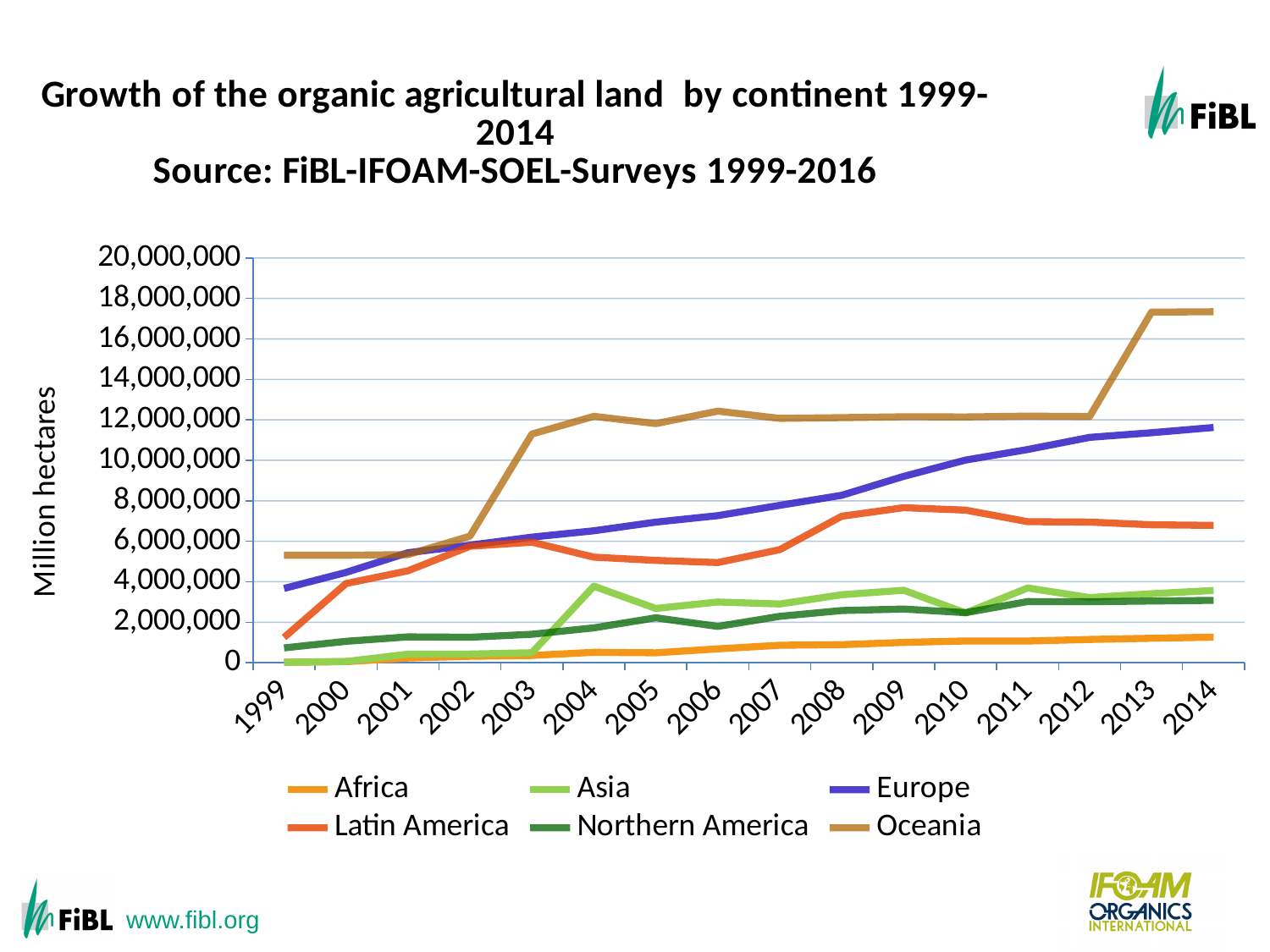
How many series does the legend list? 6 Which continent has the highest organic agricultural land in 1999? Oceania Is the value for Oceania in 2014 greater or less than 16,000,000? greater What kind of chart is shown on the slide? line chart In 2004, which is larger: the value for Asia or the value for Northern America? Asia Is the value for Europe in 2014 greater or less than 10,000,000? greater Is the value for Latin America in 1999 greater or less than 2,000,000? less Which continent has the highest organic agricultural land in 2014? Oceania How many years are shown along the x axis? 16 Which continent has the lowest organic agricultural land in 2014? Africa Does the value for Europe rise or fall from 1999 to 2014? rise In 2009, which is larger: the value for Europe or the value for Latin America? Europe